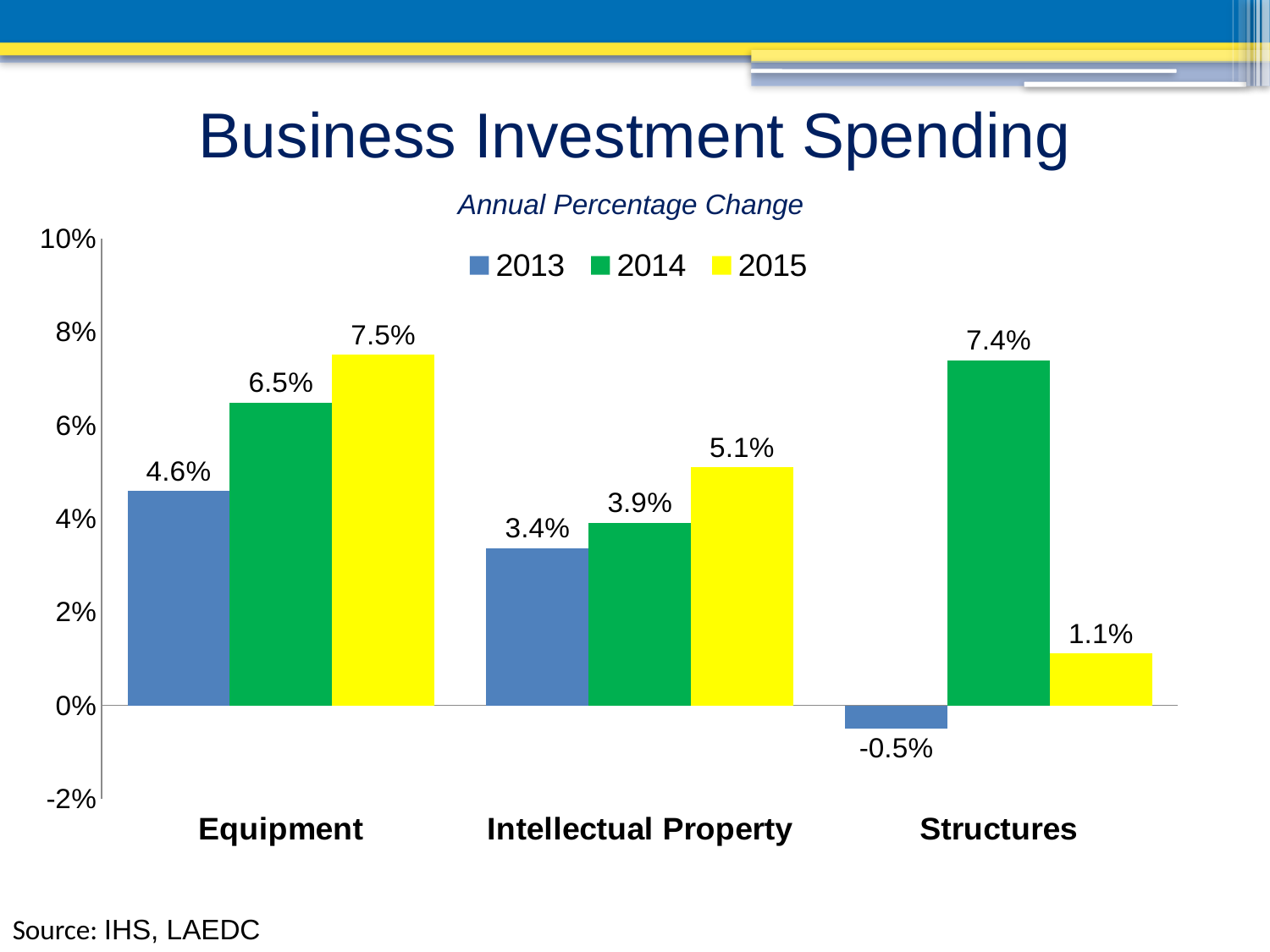
How many categories are shown on the x axis? 3 Which is larger: the 2014 value for Equipment or the 2014 value for Structures? Structures What is the 2015 value for Equipment? 7.5% How many series does the legend list? 3 What kind of chart is shown on the slide? bar chart Which category has the highest 2014 value? Structures Is the 2015 value for Intellectual Property greater or less than 4%? greater What is the 2013 value for Structures? -0.5% What is the 2014 value for Intellectual Property? 3.9% Which category has the lowest 2015 value? Structures Do the values for Intellectual Property rise or fall from 2013 to 2015? rise What is the difference between the 2015 and 2013 values for Equipment? 2.9%